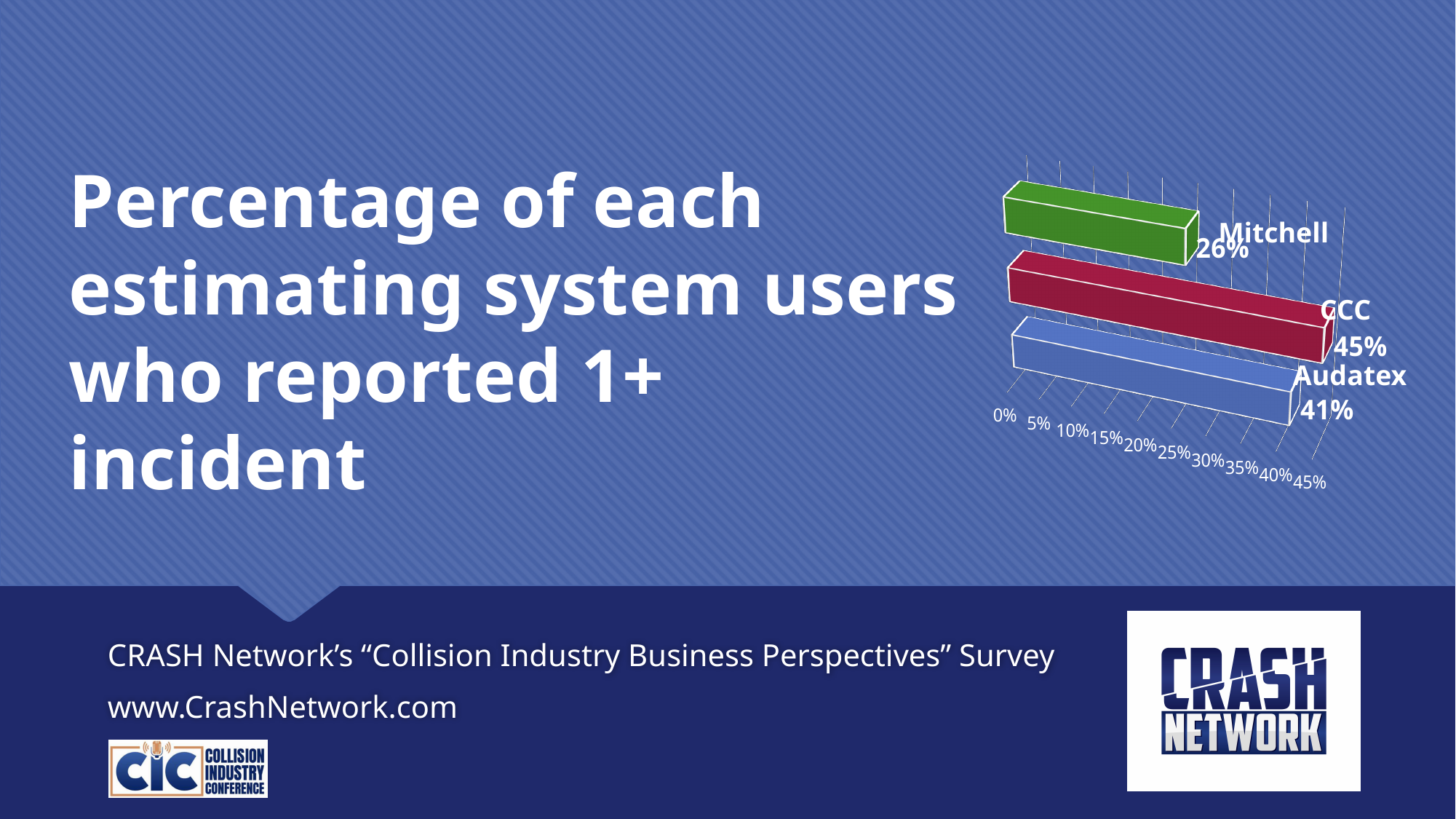
Which estimating system has the highest percentage of users reporting 1+ incident? CCC What is the difference in percentage points between Audatex and Mitchell? 15 Is the value for Mitchell greater or less than 30%? less What is the title of the chart on the slide? Percentage of each estimating system users who reported 1+ incident Which estimating system has the lowest percentage of users reporting 1+ incident? Mitchell How many estimating systems are shown in the chart? 3 What percentage of CCC users reported 1+ incident? 45% What kind of chart is shown on the slide? Bar chart What is the difference in percentage points between CCC and Mitchell? 19 What percentage of Audatex users reported 1+ incident? 41% Which has a higher percentage, CCC or Audatex? CCC What percentage of Mitchell users reported 1+ incident? 26%